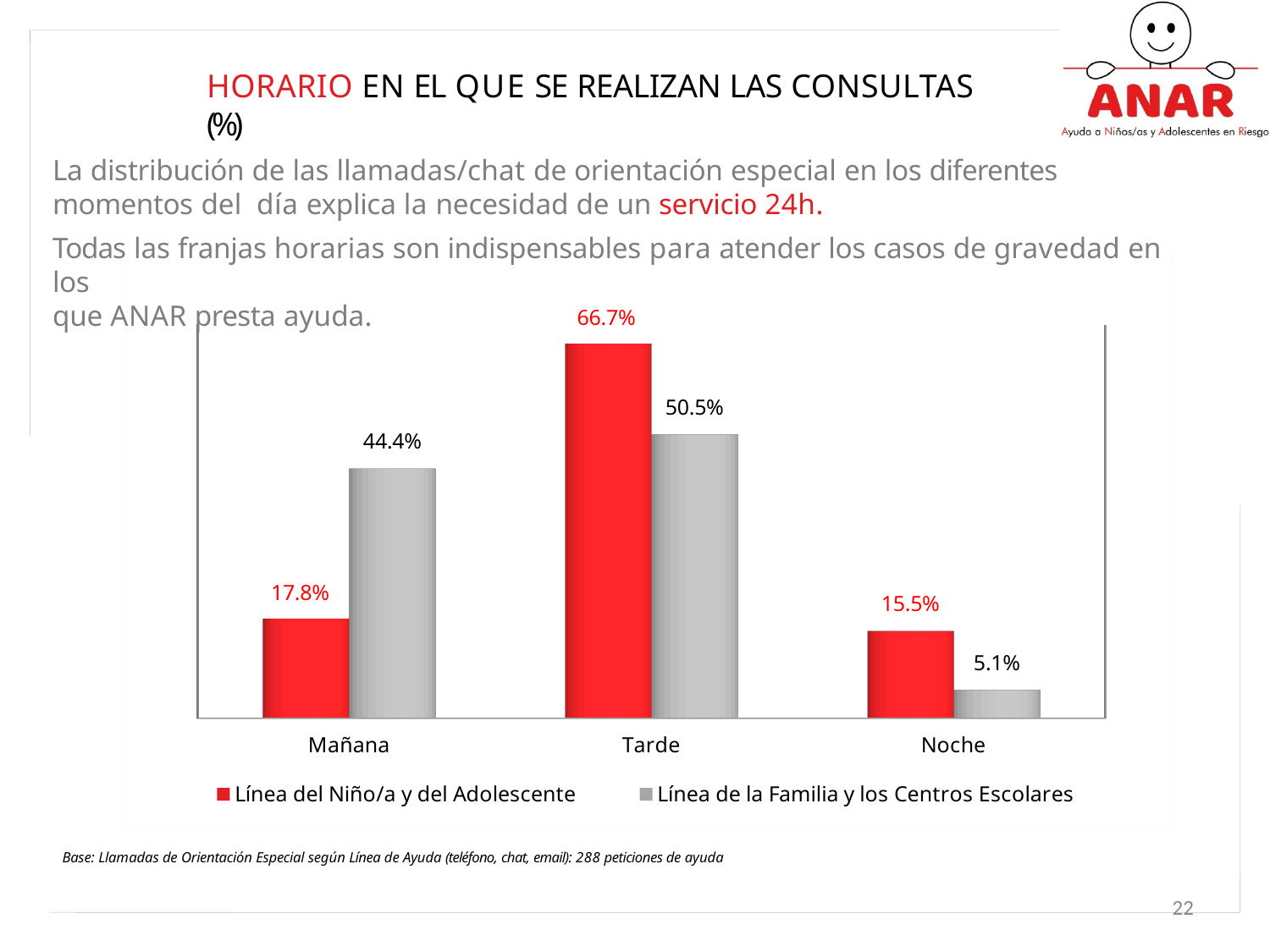
What is the difference between the Tarde values of the two series? 16.2% How many time slots are shown on the x axis? 3 What is the difference between the Mañana values of Línea de la Familia y los Centros Escolares and Línea del Niño/a y del Adolescente? 26.6% What kind of chart is shown on the slide? Bar chart Which time slot has the highest value for Línea del Niño/a y del Adolescente? Tarde What is the value for Tarde in the Línea de la Familia y los Centros Escolares series? 50.5% For Noche, which series has the larger value? Línea del Niño/a y del Adolescente How many series does the legend list? 2 Which time slot has the lowest value for Línea de la Familia y los Centros Escolares? Noche What is the value for Noche in the Línea de la Familia y los Centros Escolares series? 5.1% What is the value for Mañana in the Línea del Niño/a y del Adolescente series? 17.8% For Mañana, which series has the larger value? Línea de la Familia y los Centros Escolares